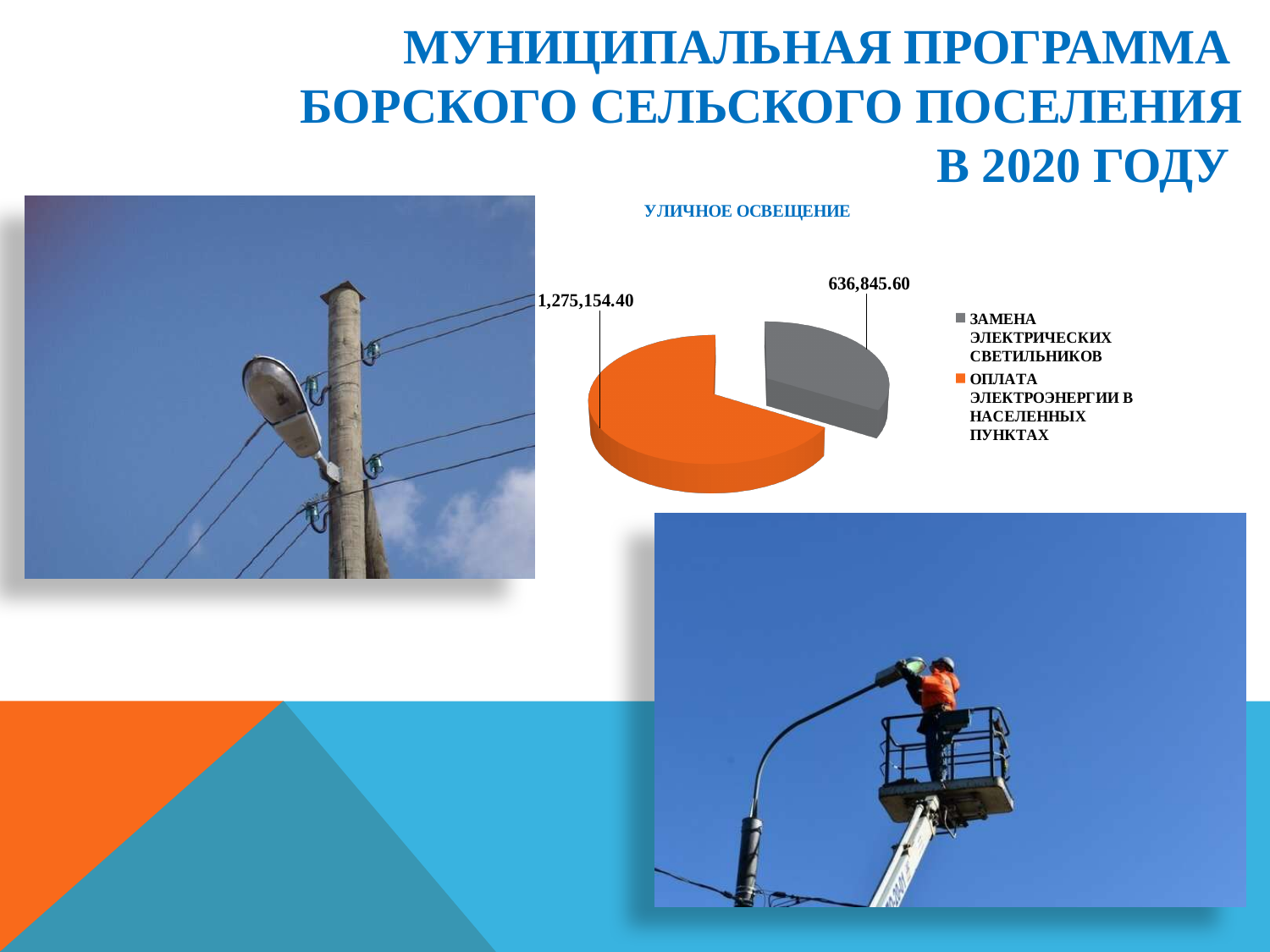
Which is larger in the pie chart: ЗАМЕНА ЭЛЕКТРИЧЕСКИХ СВЕТИЛЬНИКОВ or ОПЛАТА ЭЛЕКТРОЭНЕРГИИ В НАСЕЛЕННЫХ ПУНКТАХ? ОПЛАТА ЭЛЕКТРОЭНЕРГИИ В НАСЕЛЕННЫХ ПУНКТАХ What is the value for ЗАМЕНА ЭЛЕКТРИЧЕСКИХ СВЕТИЛЬНИКОВ in the pie chart? 636,845.60 Which category has the smallest slice in the pie chart? ЗАМЕНА ЭЛЕКТРИЧЕСКИХ СВЕТИЛЬНИКОВ How many slices does the pie chart have? 2 What colour is the slice for ОПЛАТА ЭЛЕКТРОЭНЕРГИИ В НАСЕЛЕННЫХ ПУНКТАХ in the pie chart? Orange How many entries does the legend of the pie chart list? 2 What is the difference between the values for ОПЛАТА ЭЛЕКТРОЭНЕРГИИ В НАСЕЛЕННЫХ ПУНКТАХ and ЗАМЕНА ЭЛЕКТРИЧЕСКИХ СВЕТИЛЬНИКОВ in the pie chart? 638,308.80 What is the title of the pie chart? УЛИЧНОЕ ОСВЕЩЕНИЕ What type of chart is shown under the title УЛИЧНОЕ ОСВЕЩЕНИЕ? Pie chart Which category has the largest slice in the pie chart? ОПЛАТА ЭЛЕКТРОЭНЕРГИИ В НАСЕЛЕННЫХ ПУНКТАХ What is the value for ОПЛАТА ЭЛЕКТРОЭНЕРГИИ В НАСЕЛЕННЫХ ПУНКТАХ in the pie chart? 1,275,154.40 What is the total of the two values shown in the pie chart? 1,912,000.00